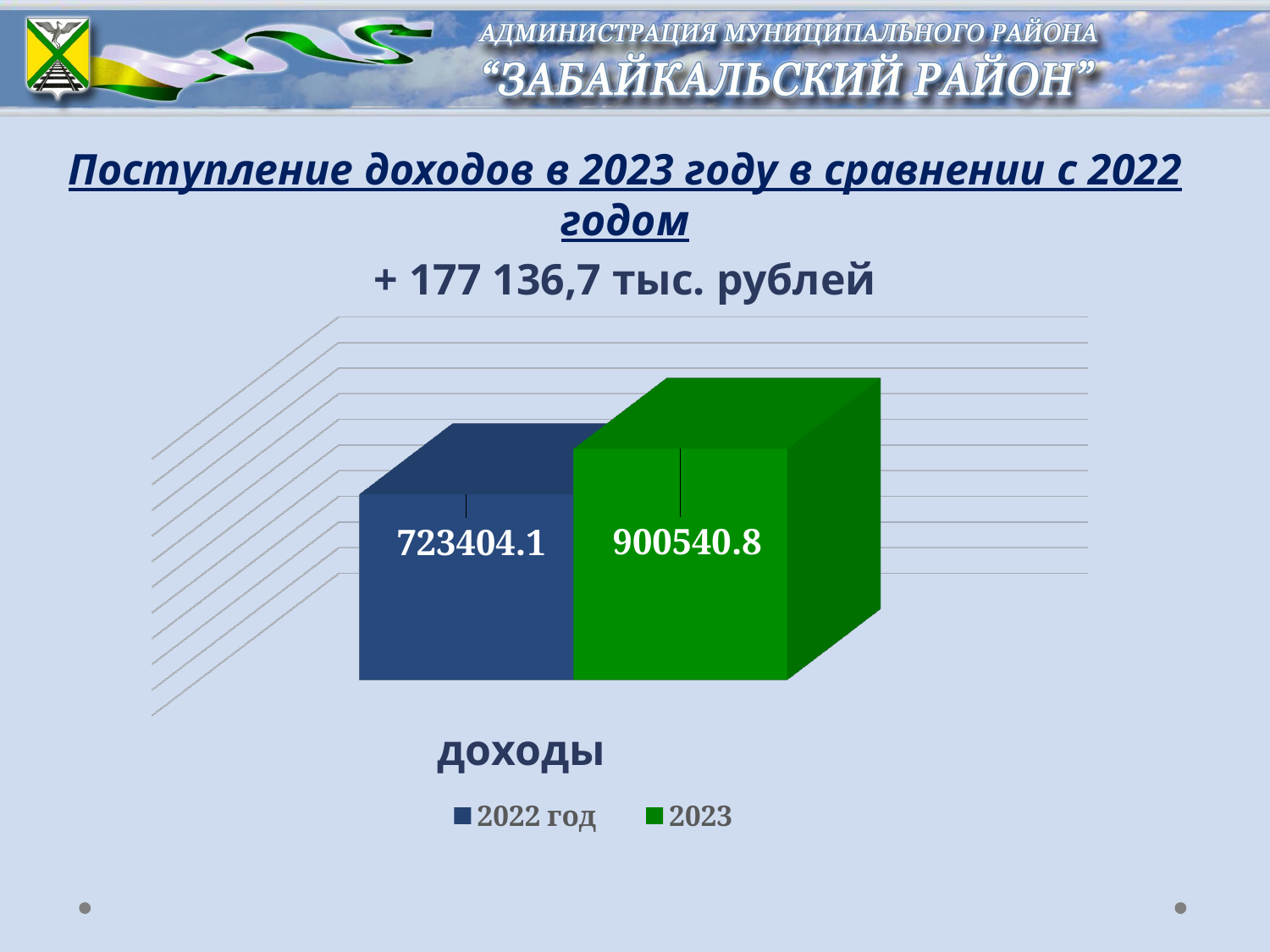
What is the value for the 2022 год series in the chart? 723404.1 What kind of chart is shown on the slide? bar chart Which series has the higher value, 2022 год or 2023? 2023 What is the difference between the 2023 value and the 2022 год value? 177136.7 Which series has the highest value in the chart? 2023 What is the category label shown on the x axis of the chart? доходы How many categories are shown on the x axis of the chart? 1 What is the value for the 2023 series in the chart? 900540.8 What colour is the bar for the 2023 series? green Which series has the lowest value in the chart? 2022 год How many series does the legend list? 2